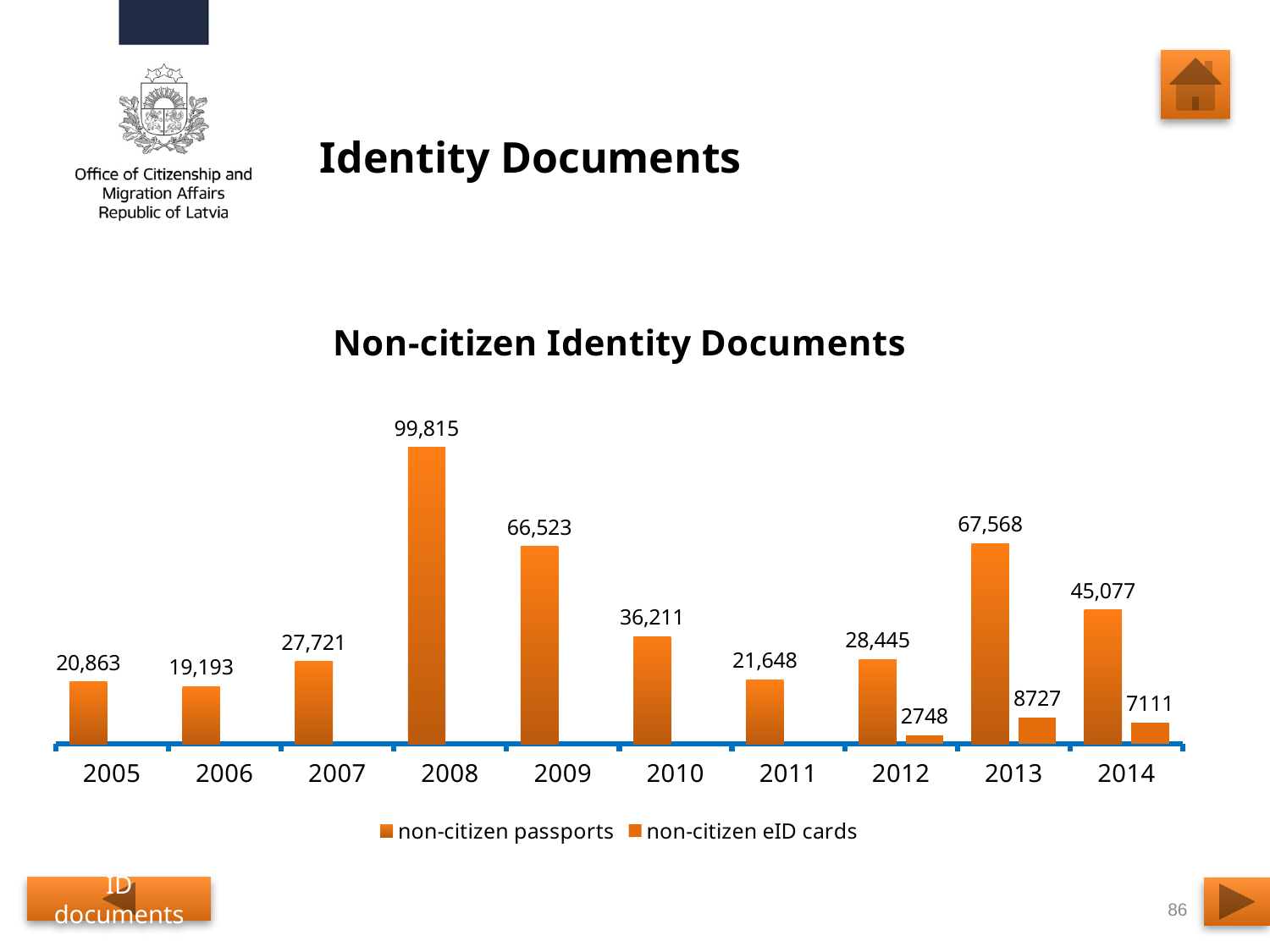
Do the values for non-citizen eID cards rise or fall from 2013 to 2014? fall Which is larger, non-citizen passports in 2009 or in 2013? 2013 How many years are shown on the x axis? 10 What is the value for non-citizen eID cards in 2013? 8727 What is the value for non-citizen passports in 2008? 99,815 What is the value for non-citizen passports in 2014? 45,077 What is the title of the chart? Non-citizen Identity Documents Which year has the highest value for non-citizen passports? 2008 What is the difference between non-citizen passports in 2013 and 2014? 22,491 What kind of chart is shown? bar chart How many series does the legend list? 2 Which year has the lowest value for non-citizen passports? 2006